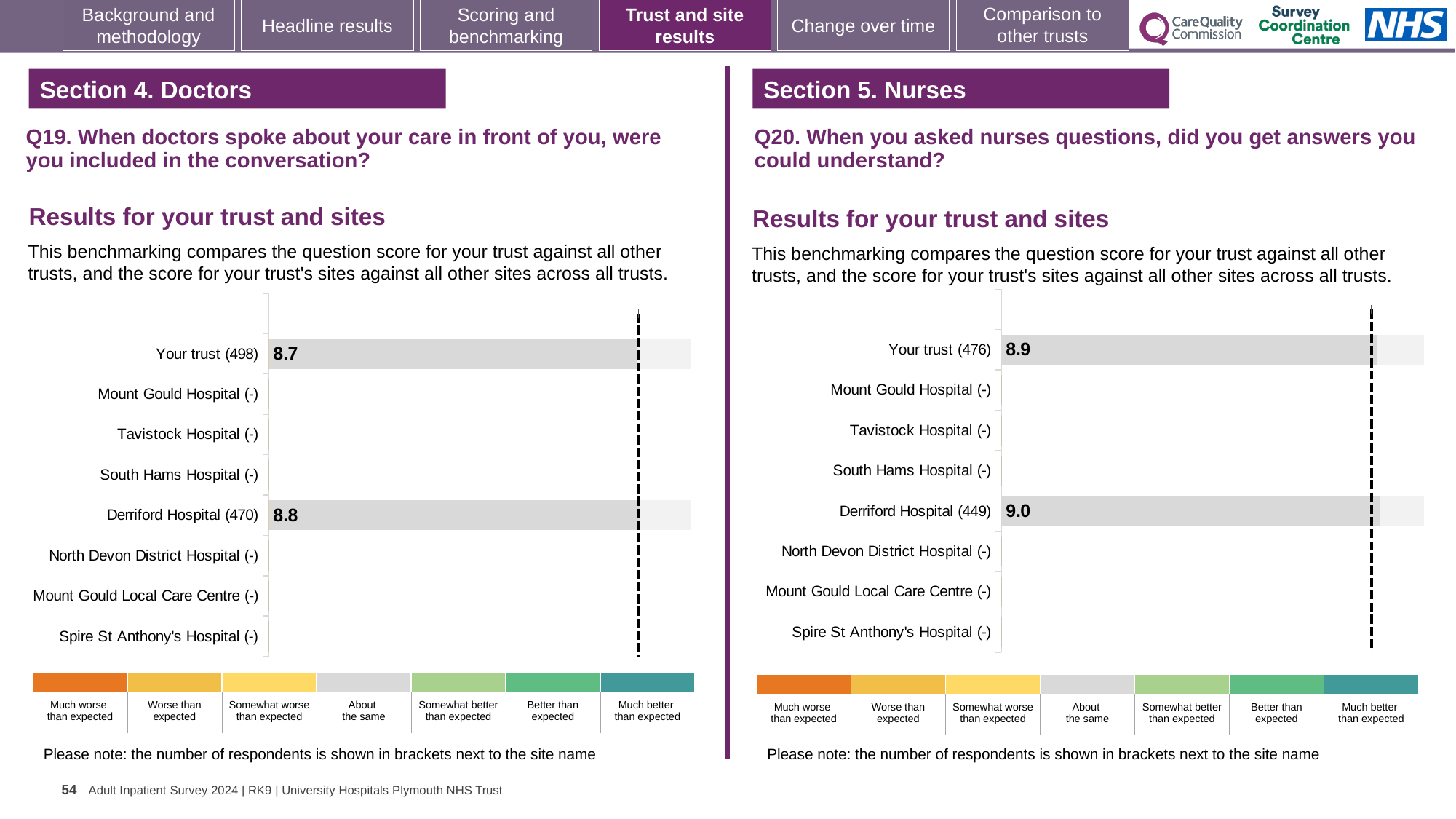
On the Q20 chart (Section 5. Nurses), what is the score for Derriford Hospital? 9.0 What type of chart is used on the Q19 chart (Section 4. Doctors)? Bar chart On the Q19 chart (Section 4. Doctors), how many respondents are shown in brackets for Derriford Hospital? 470 On the Q19 chart (Section 4. Doctors), which is higher: the score for Your trust or for Derriford Hospital? Derriford Hospital On the Q20 chart (Section 5. Nurses), how many respondents are shown in brackets for Your trust? 476 On the Q19 chart (Section 4. Doctors), what is the score for Derriford Hospital? 8.8 On the Q20 chart (Section 5. Nurses), which category has the highest score shown? Derriford Hospital On the Q20 chart (Section 5. Nurses), what is the score for Your trust? 8.9 On the Q19 chart (Section 4. Doctors), what is the difference between the Derriford Hospital score and the Your trust score? 0.1 On the Q20 chart (Section 5. Nurses), what is the difference between the Derriford Hospital score and the Your trust score? 0.1 How many site/trust categories are listed on the Q20 chart (Section 5. Nurses)? 8 On the Q19 chart (Section 4. Doctors), what is the score for Your trust? 8.7